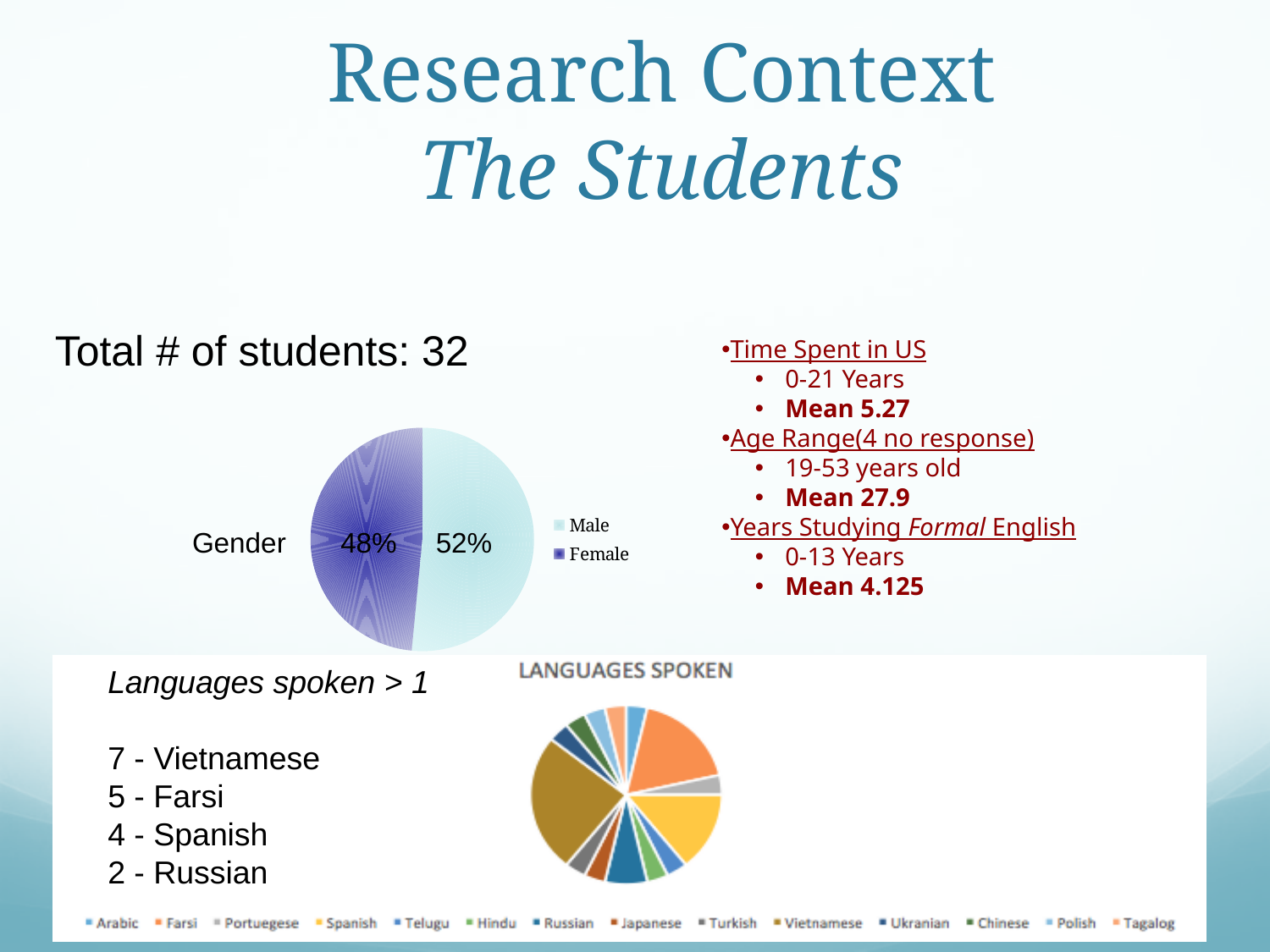
On the Gender pie chart, which legend entry is shown in the light blue colour? Male On the Gender pie chart, what percentage of students are male? 52% What is the title of the chart at the bottom of the slide? LANGUAGES SPOKEN What kind of chart is the Languages Spoken chart? pie chart On the Gender pie chart, which category has the larger share? Male On the Gender pie chart, is the female share greater or less than 50%? less What kind of chart is the Gender chart? pie chart How many languages does the legend of the Languages Spoken chart list? 14 On the Gender pie chart, how many categories are shown? 2 On the Gender pie chart, which category has the smaller share? Female On the Gender pie chart, what percentage of students are female? 48% On the Gender pie chart, what is the difference in percentage points between the male and female shares? 4%